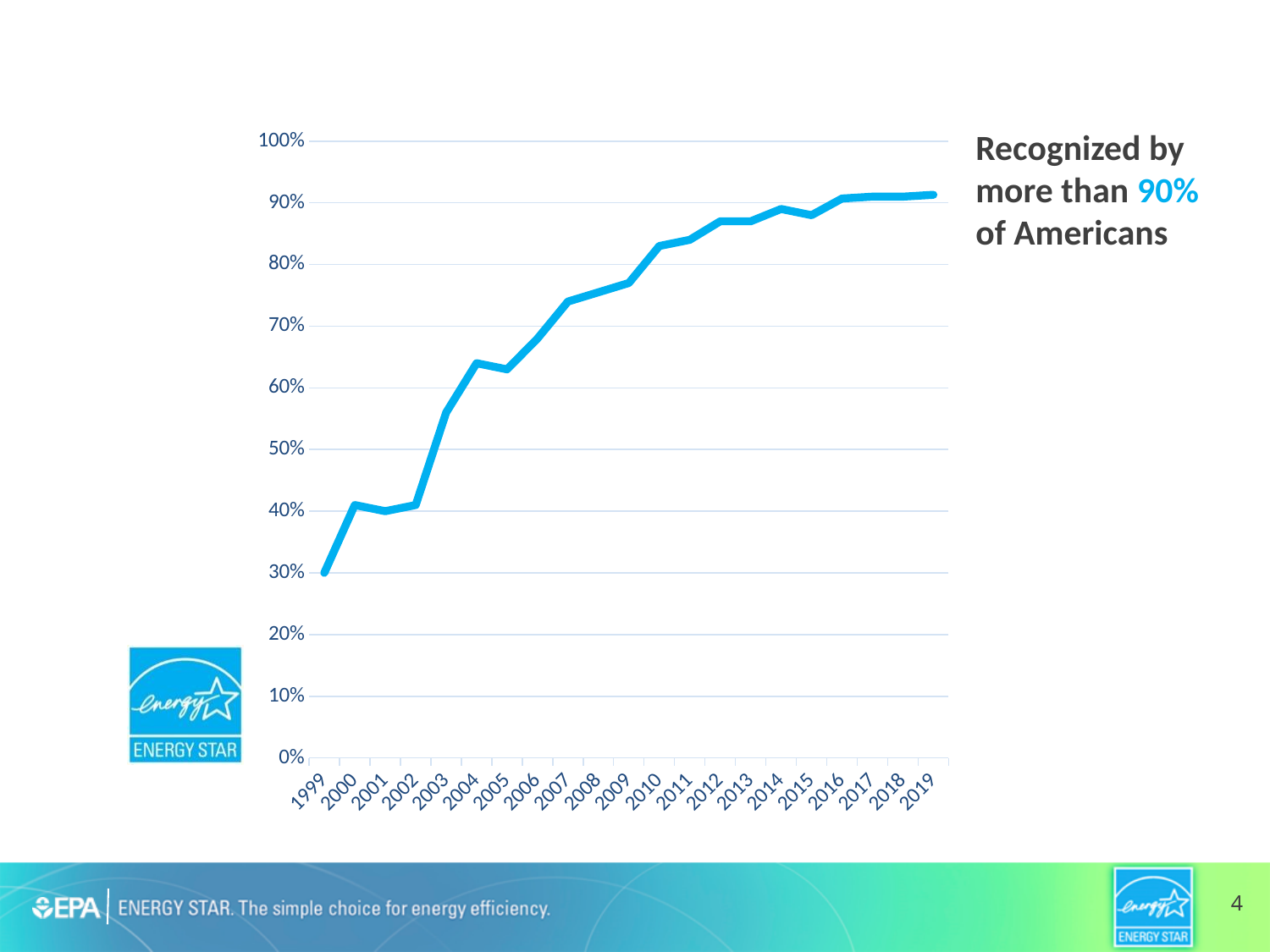
Is the value for 2010 greater or less than 80%? greater How many years are plotted along the x axis of the chart? 21 What kind of chart is shown on the slide? line chart Is the value for 2003 greater or less than 50%? greater According to the text beside the chart, ENERGY STAR is recognized by more than what share of Americans? 90% Is the value for 2009 greater or less than 80%? less Which is larger, the value for 2002 or the value for 2008? 2008 Which year has the lowest value on the chart? 1999 Which is larger, the value for 2004 or the value for 2005? 2004 Do the values generally rise or fall from 1999 to 2019? rise